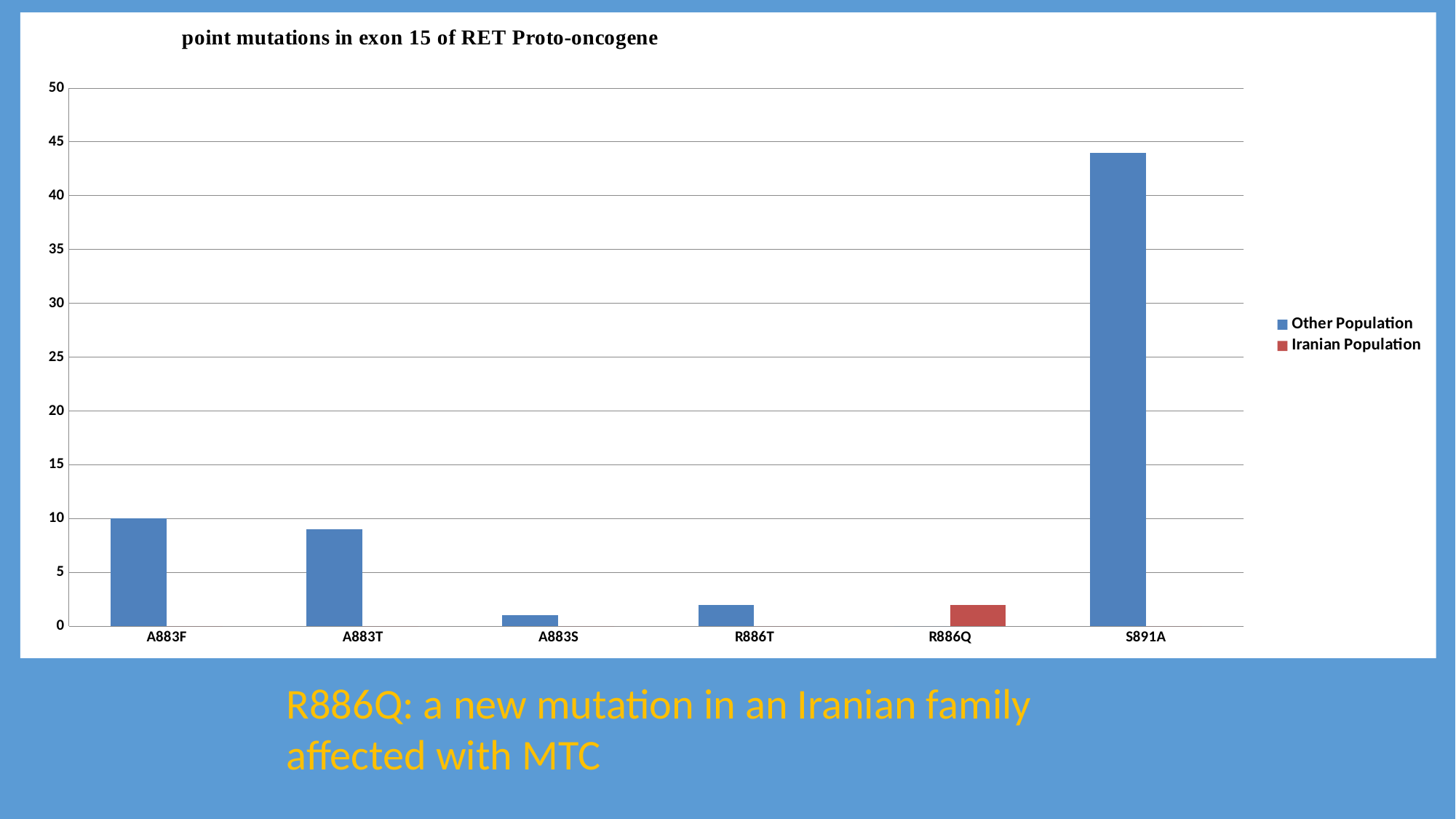
Which mutation has the lowest bar? A883S How many series does the legend list? 2 How many mutation categories are shown on the x axis? 6 Which is larger, the value for S891A or the value for A883F? S891A Is the value for A883T greater or less than 5? greater What kind of chart is shown on the slide? bar chart Is the value for R886T greater or less than 5? less What is the title of the chart? point mutations in exon 15 of RET Proto-oncogene Which series does the R886Q bar belong to, according to the legend? Iranian Population Which mutation has the highest bar? S891A Is the value for S891A greater or less than 40? greater What is the value for A883F? 10